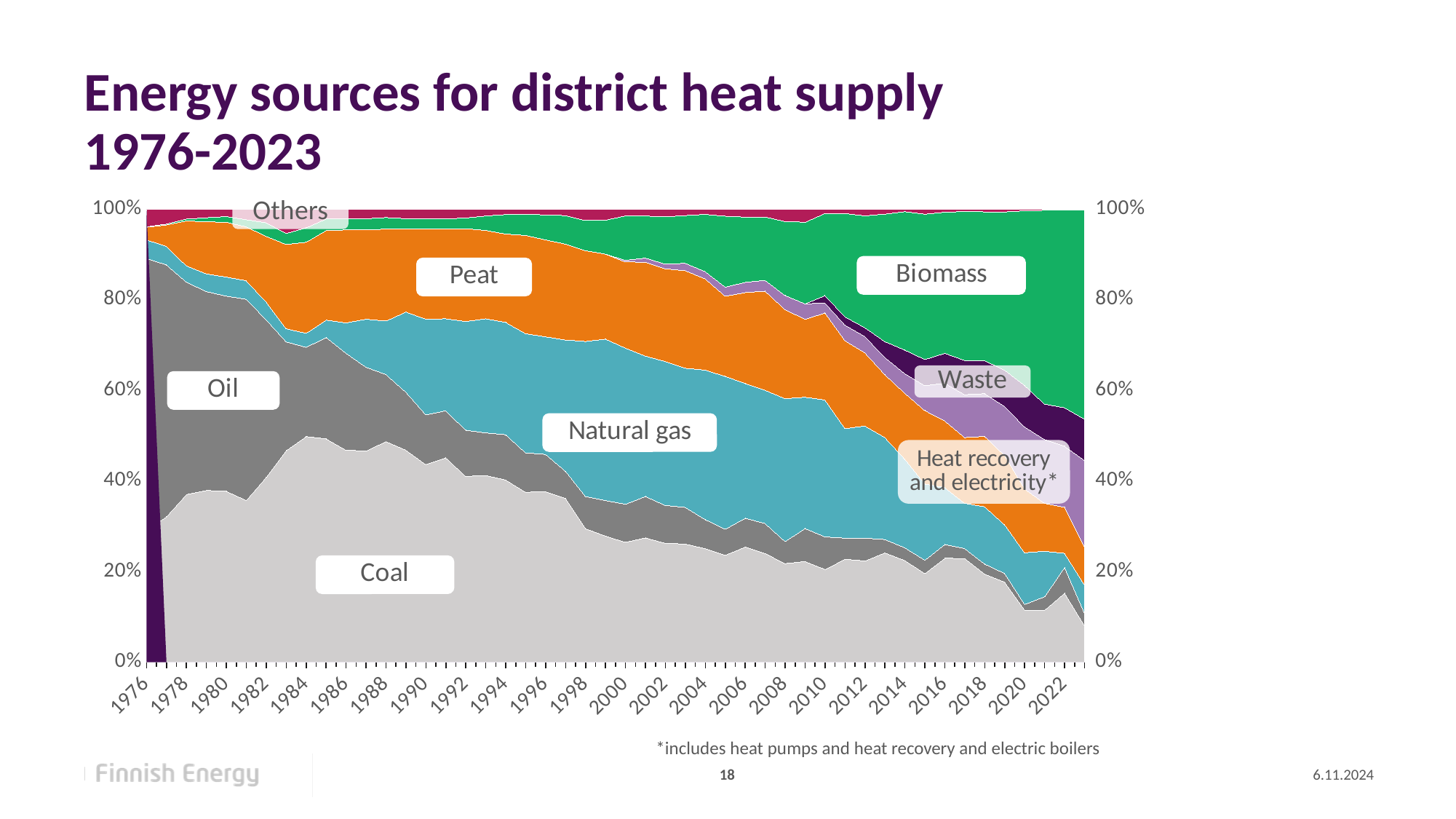
Is the share of coal in 2023 greater or less than 20%? less What is the first year shown on the x axis? 1976 What is the maximum value shown on the y axis? 100% Is the share of coal in 1990 greater or less than 20%? greater What is the title of the chart? Energy sources for district heat supply 1976-2023 Does the share of oil rise or fall between 1978 and 2023? Fall What kind of chart is shown on the slide? Stacked area chart Which energy source is labelled in the green area at the top right of the chart? Biomass Does the share of coal rise or fall between 1984 and 2023? Fall Is the share of biomass in 2023 greater or less than 40%? greater Does the share of biomass rise or fall between 2000 and 2023? Rise How many energy sources are labelled on the chart? 8